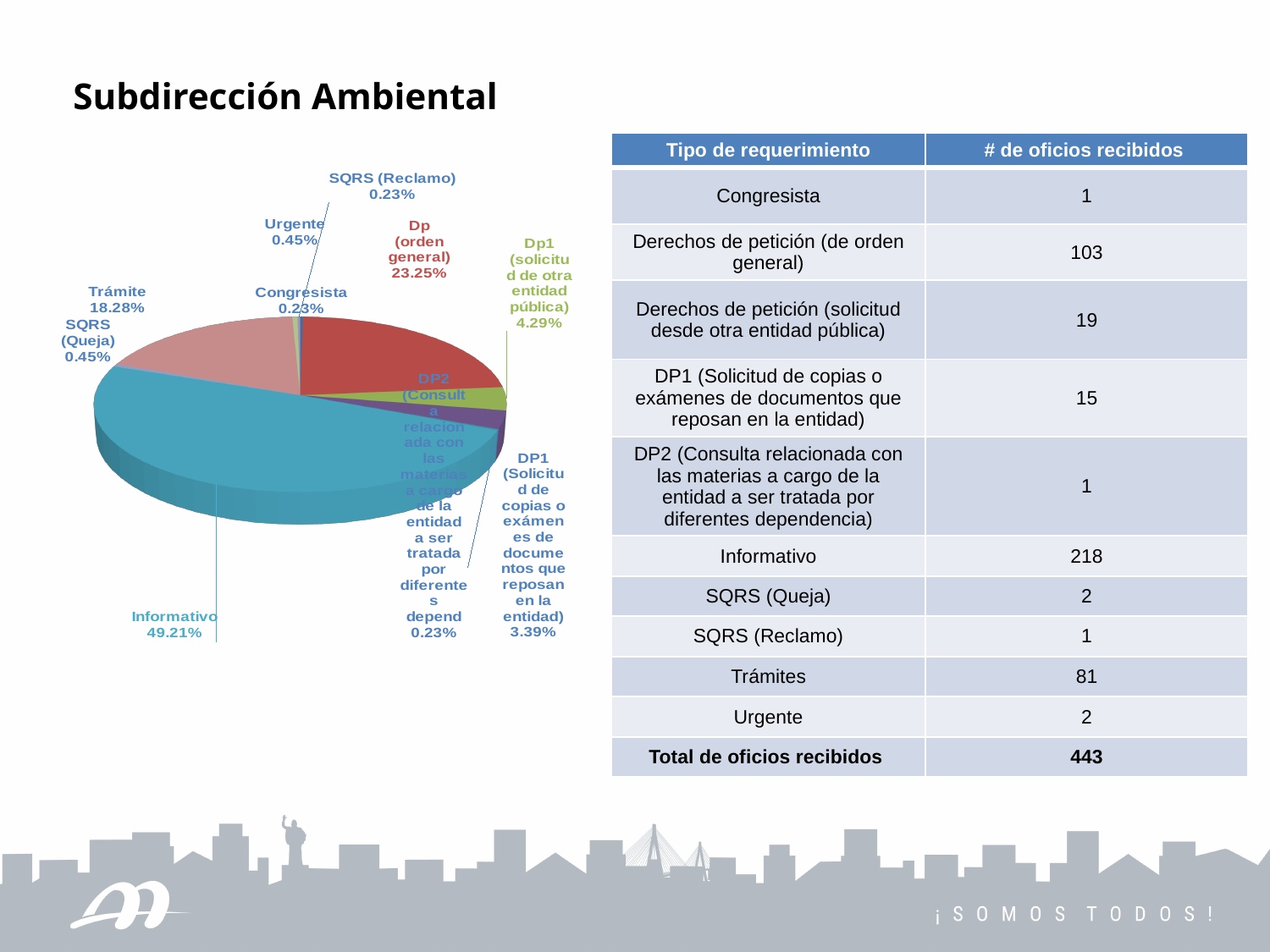
Which is larger in the pie chart, Dp (orden general) or Trámite? Dp (orden general) How many slices does the pie chart have? 10 What percentage is shown for SQRS (Reclamo) in the pie chart? 0.23% What is the difference in percentage points between Informativo and Dp (orden general) in the pie chart? 25.96 What percentage is shown for Dp (orden general) in the pie chart? 23.25% What is the title of the slide containing the pie chart? Subdirección Ambiental What kind of chart is shown on the slide? pie chart What share of the pie does Informativo represent? 49.21% What percentage is shown for Trámite in the pie chart? 18.28% What percentage is shown for Dp1 (solicitud de otra entidad pública) in the pie chart? 4.29% What percentage is shown for Urgente in the pie chart? 0.45% Which category has the largest slice of the pie chart? Informativo